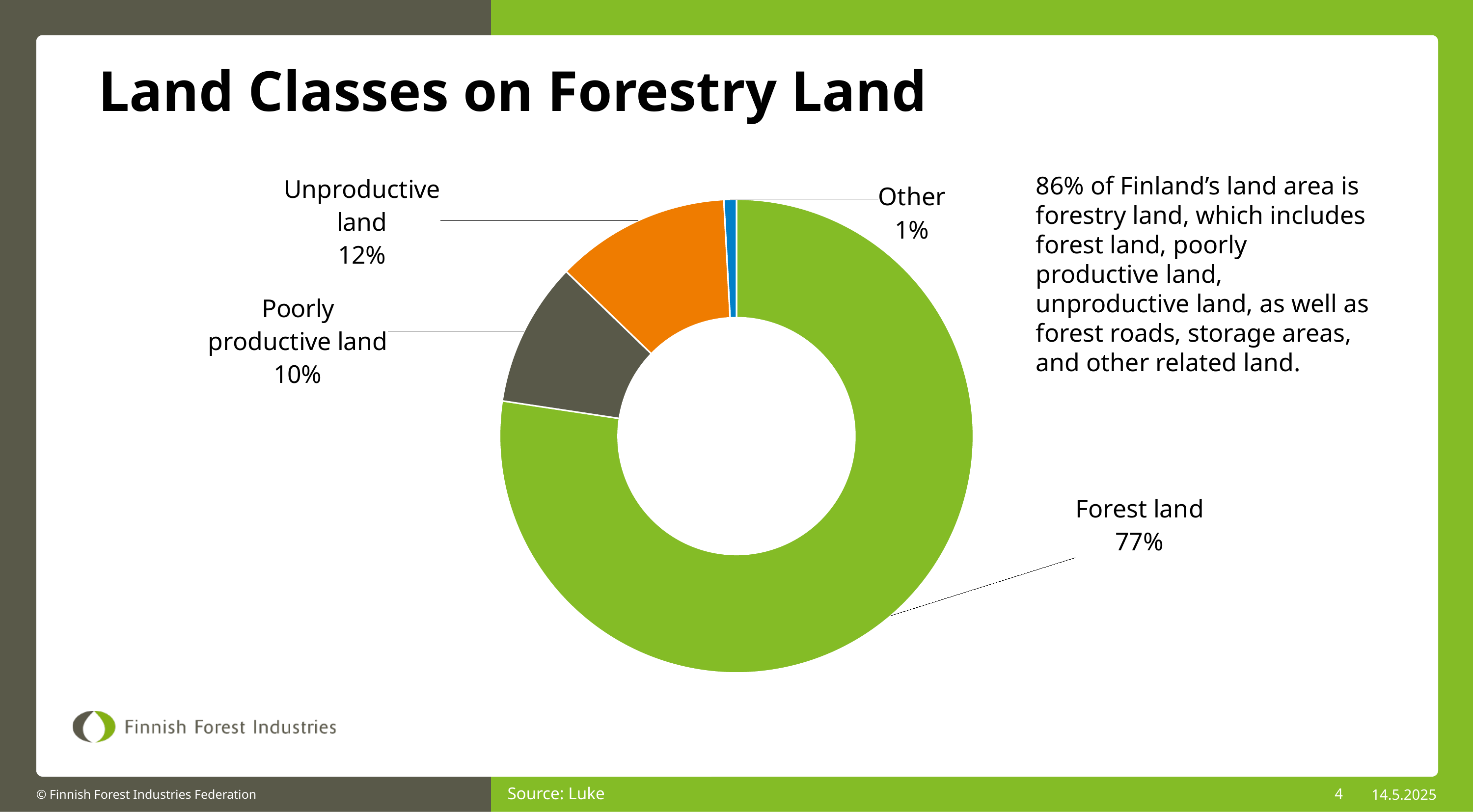
Which land class has the smallest share of forestry land? Other What share of forestry land is Forest land? 77% What share of forestry land is Poorly productive land? 10% What kind of chart is shown on the slide? Pie chart (doughnut) Which land class has the largest share of forestry land? Forest land How many land classes are shown in the chart? 4 What colour is the Unproductive land slice? Orange How many percentage points larger is the Forest land share than the Unproductive land share? 65 Which is larger, the share of Unproductive land or the share of Poorly productive land? Unproductive land What is the difference in percentage points between Unproductive land and Poorly productive land? 2 What share of forestry land is labelled Other? 1% What share of forestry land is Unproductive land? 12%